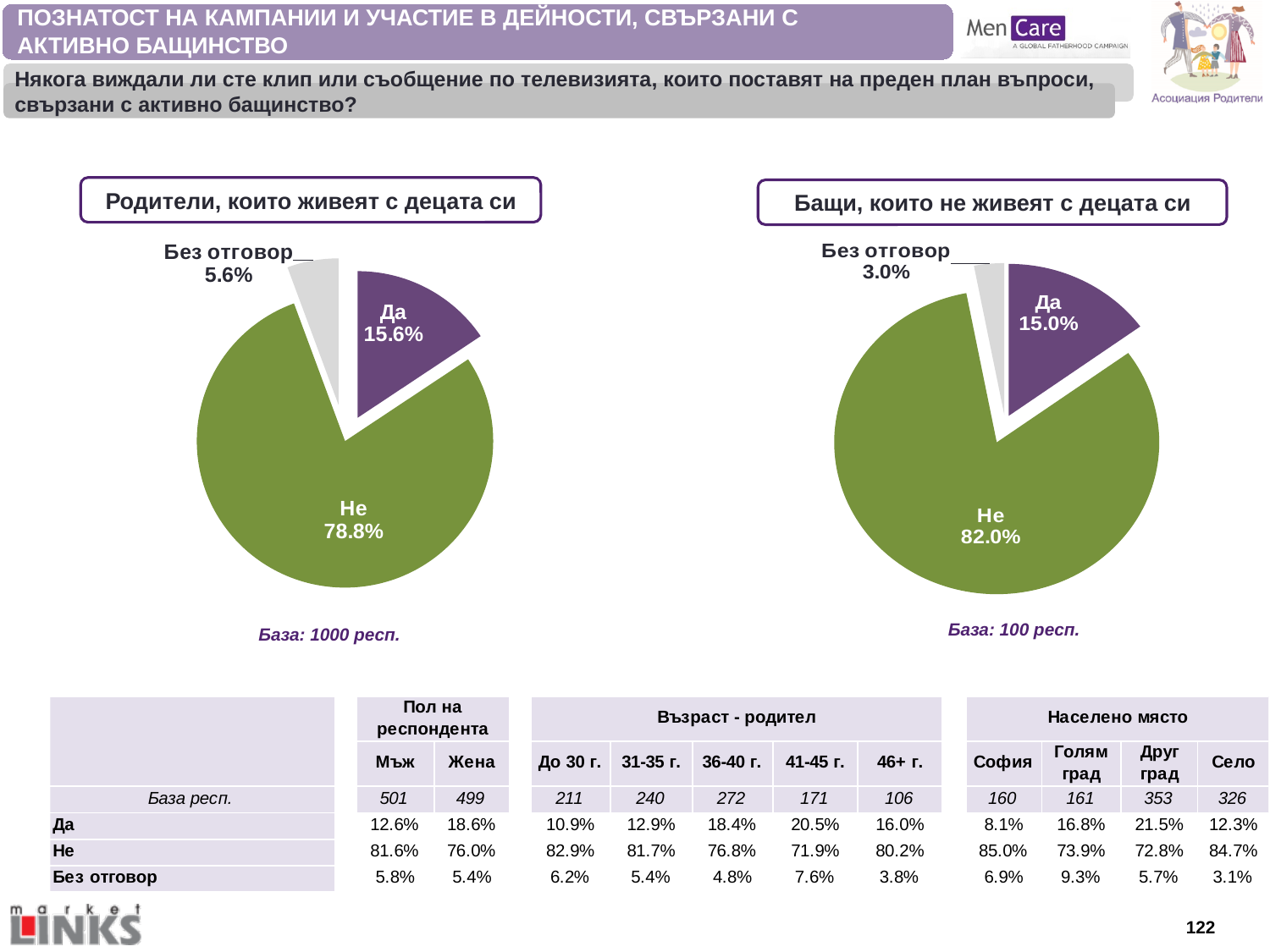
In the chart titled "Бащи, които не живеят с децата си", what is the difference between the "Да" and "Без отговор" shares? 12.0% In the chart titled "Родители, които живеят с децата си", what is the difference between the "Не" and "Да" shares? 63.2% Which chart has the larger "Не" share: "Родители, които живеят с децата си" or "Бащи, които не живеят с децата си"? Бащи, които не живеят с децата си In the chart titled "Бащи, които не живеят с децата си", what is the value for "Без отговор"? 3.0% In the chart titled "Бащи, които не живеят с децата си", what is the value for "Не"? 82.0% How many slices does the chart titled "Бащи, които не живеят с децата си" have? 3 What type of chart is the one titled "Родители, които живеят с децата си"? Pie chart In the chart titled "Родители, които живеят с децата си", what is the value for "Да"? 15.6% What base (number of respondents) is shown under the chart titled "Бащи, които не живеят с децата си"? 100 респ. In the chart titled "Родители, които живеят с децата си", which category has the largest share? Не In the chart titled "Родители, които живеят с децата си", what is the value for "Не"? 78.8% In the chart titled "Бащи, които не живеят с децата си", which category has the smallest share? Без отговор